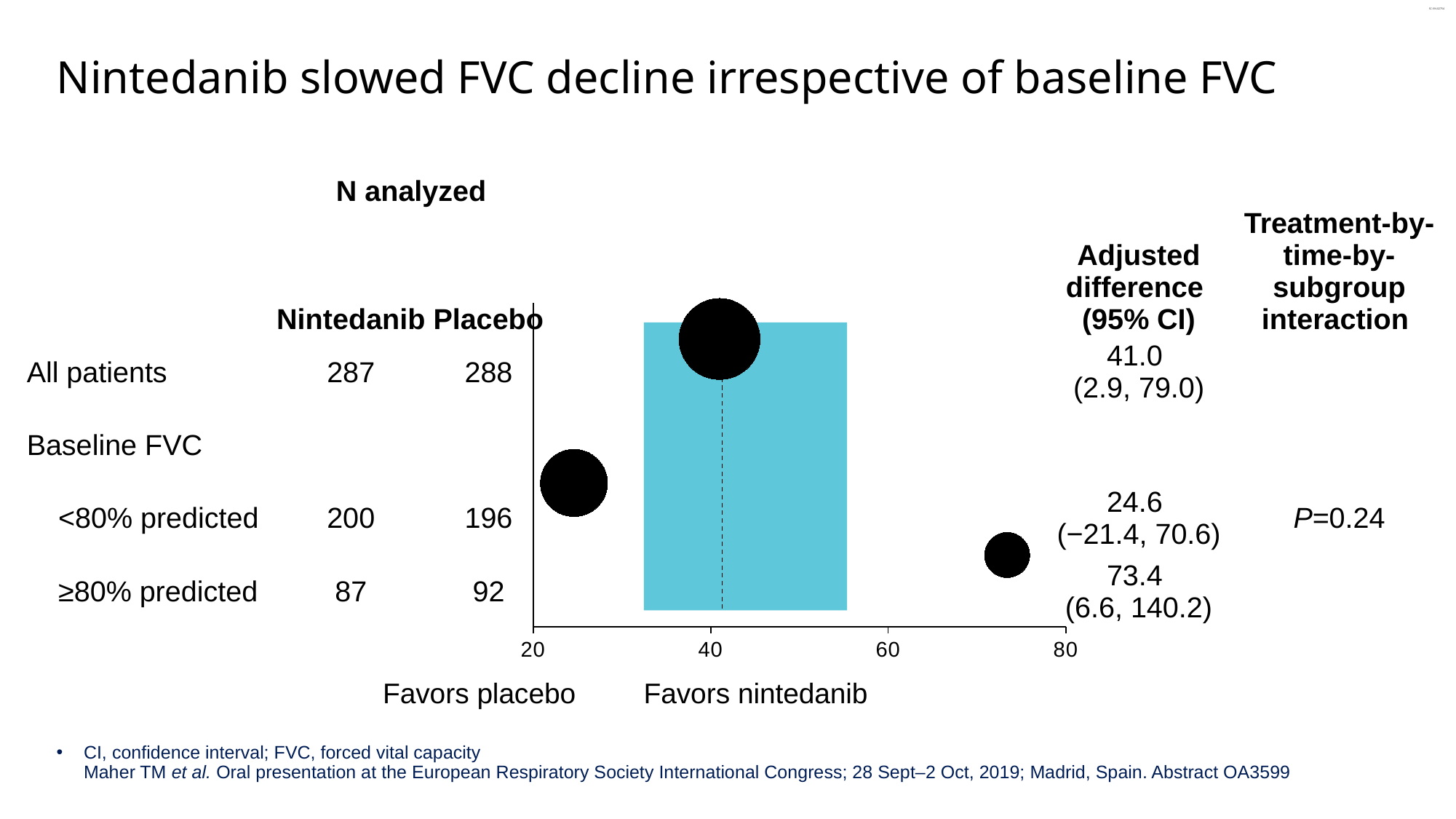
Which subgroup has the highest adjusted difference? ≥80% predicted What is the 95% CI for the adjusted difference in the ≥80% predicted subgroup? (6.6, 140.2) How many nintedanib patients were analyzed in the <80% predicted subgroup? 200 Which subgroup has the lowest adjusted difference? <80% predicted Is the adjusted difference for the <80% predicted subgroup greater or less than 40? less What is the adjusted difference for all patients? 41.0 How many data points are plotted in the forest plot? 3 What is the adjusted difference for the <80% predicted baseline FVC subgroup? 24.6 What is the adjusted difference for the ≥80% predicted baseline FVC subgroup? 73.4 What is the difference between the adjusted difference for the ≥80% predicted subgroup and the <80% predicted subgroup? 48.8 Is the adjusted difference for the ≥80% predicted subgroup greater or less than 60? greater What is the P value for the treatment-by-time-by-subgroup interaction? P=0.24